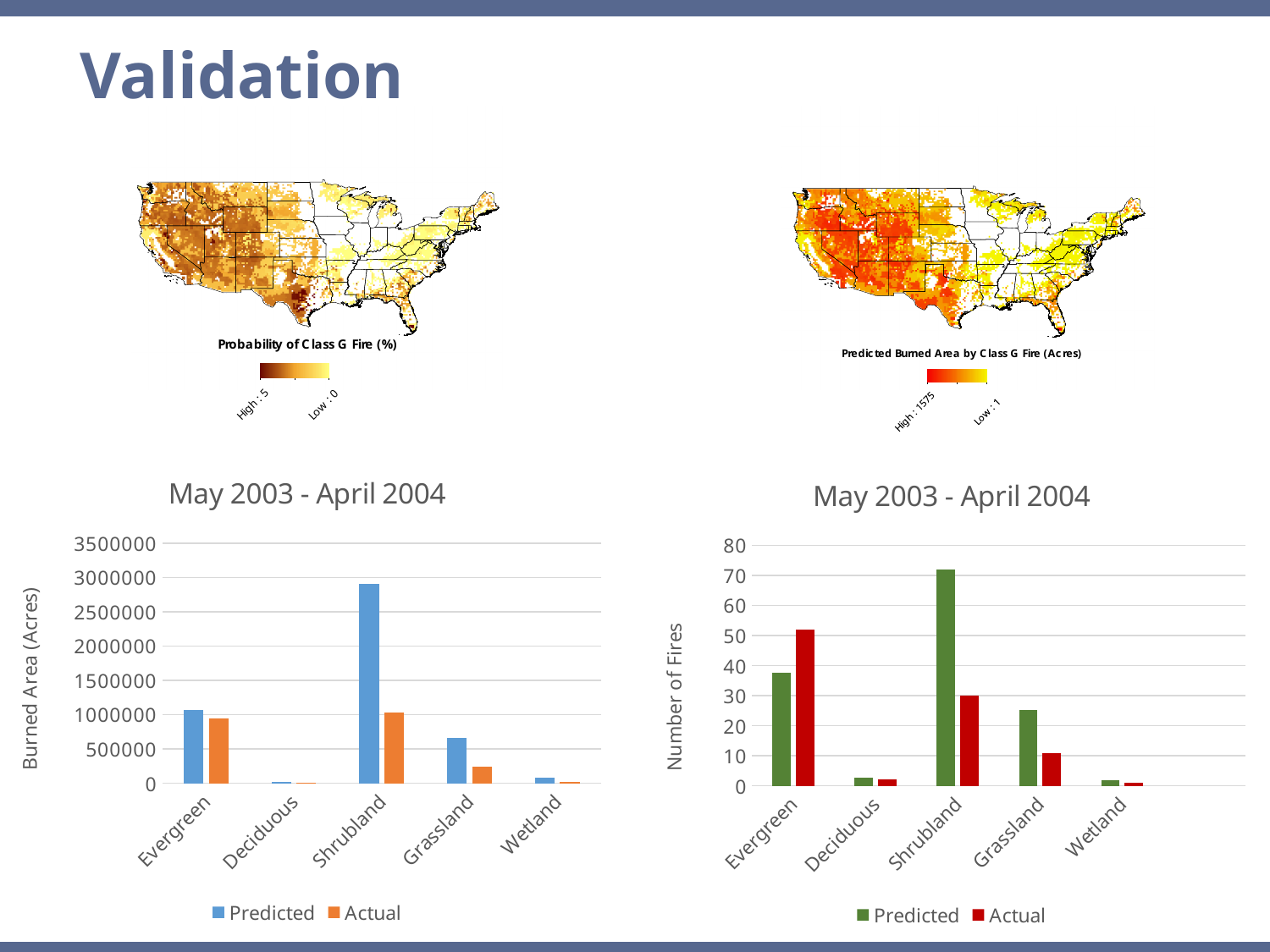
How many series does the legend of the left chart (Burned Area (Acres)) list? 2 In the left chart (Burned Area (Acres)), is the Predicted value for Shrubland greater or less than 2500000? greater What is the y-axis label of the right chart? Number of Fires In the left chart (Burned Area (Acres)), which category has the highest Predicted value? Shrubland How many categories are shown on the x axis of the left chart (Burned Area (Acres))? 5 In the right chart (Number of Fires), which category has the highest Predicted value? Shrubland In the left chart (Burned Area (Acres)), is the Actual value for Evergreen greater or less than 1000000? less In the right chart (Number of Fires), is the Actual value for Evergreen greater or less than 40? greater In the left chart (Burned Area (Acres)), which is larger for Shrubland, Predicted or Actual? Predicted In the right chart (Number of Fires), which is larger for Evergreen, Predicted or Actual? Actual What kind of chart is the left chart (Burned Area (Acres))? bar chart